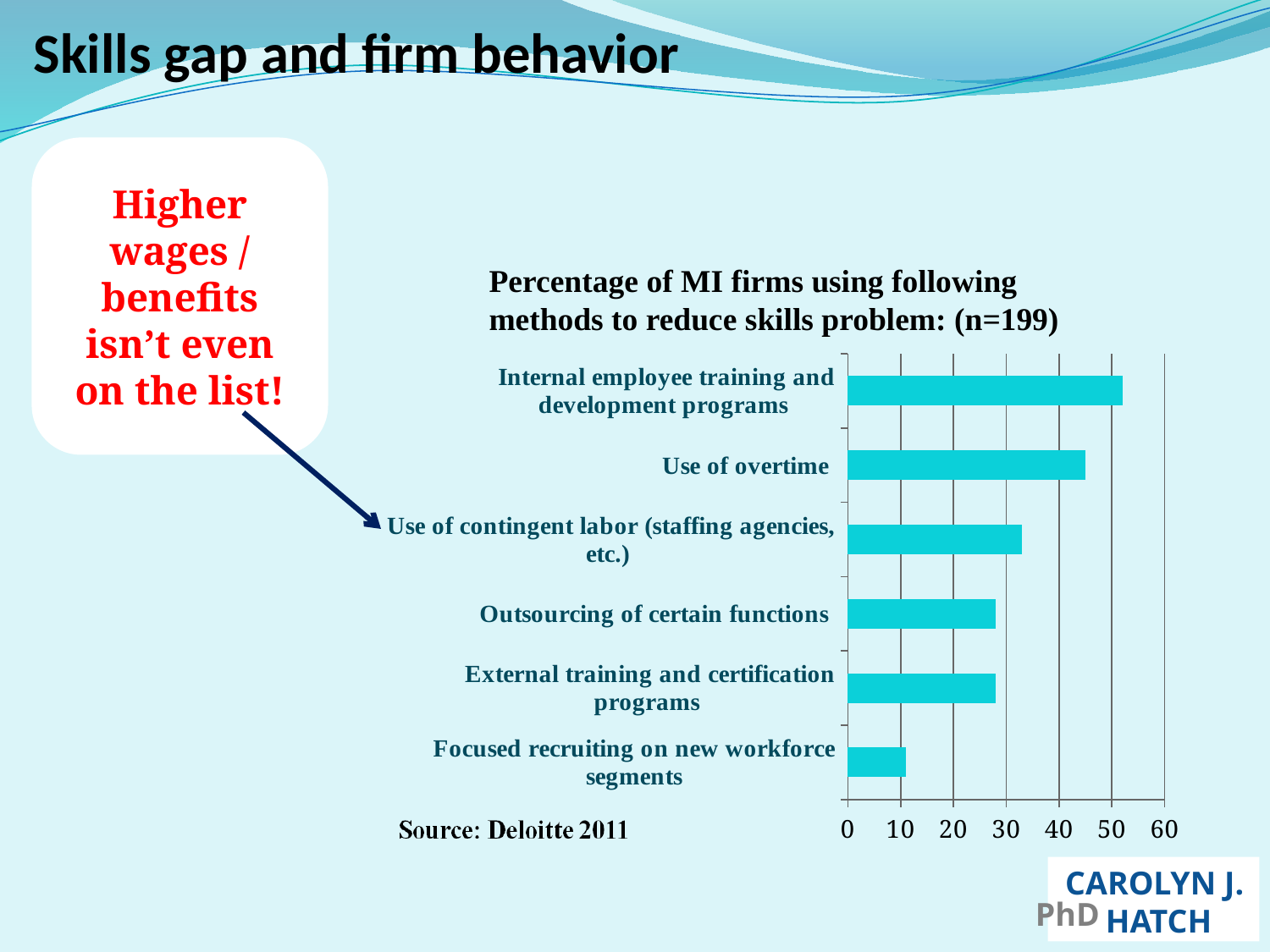
Which is larger: the value for Internal employee training and development programs or the value for Use of overtime? Internal employee training and development programs Is the value for Focused recruiting on new workforce segments greater or less than 20? less Is the value for Internal employee training and development programs greater or less than 40? greater What source is cited for the chart? Deloitte 2011 What kind of chart is shown on the slide? bar chart What is the sample size (n) stated in the chart title? 199 Is the value for Use of overtime greater or less than 40? greater Which is larger: the value for Use of contingent labor (staffing agencies, etc.) or the value for Focused recruiting on new workforce segments? Use of contingent labor (staffing agencies, etc.) Which method has the highest percentage of MI firms using it? Internal employee training and development programs Which method has the lowest percentage of MI firms using it? Focused recruiting on new workforce segments How many methods (categories) are plotted in the chart? 6